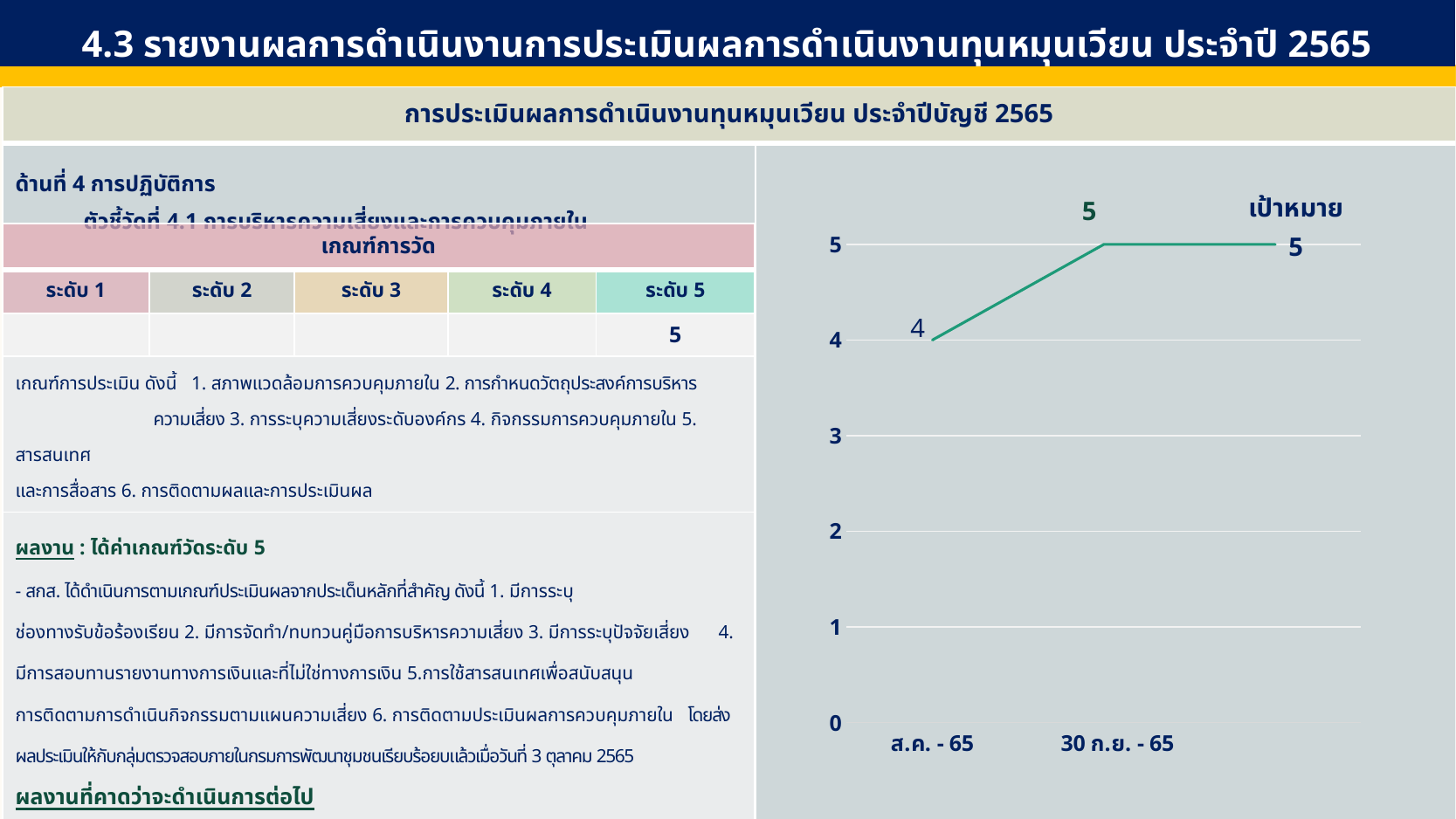
Does the line rise or fall from ส.ค. - 65 to 30 ก.ย. - 65? rise Which x-axis category has the lowest value in the line chart? ส.ค. - 65 What is the highest value shown on the y axis of the line chart? 5 What colour is the line in the chart? green What is the value for 30 ก.ย. - 65 in the line chart? 5 What kind of chart is shown on the right side of the slide? line chart How many labelled categories are on the x axis of the line chart? 2 What value is shown for เป้าหมาย (target) in the line chart? 5 Is the value for ส.ค. - 65 greater or less than 3? greater Which is larger, the value for ส.ค. - 65 or the value for 30 ก.ย. - 65? 30 ก.ย. - 65 What is the difference between the value for 30 ก.ย. - 65 and the value for ส.ค. - 65? 1 What is the value for ส.ค. - 65 in the line chart? 4